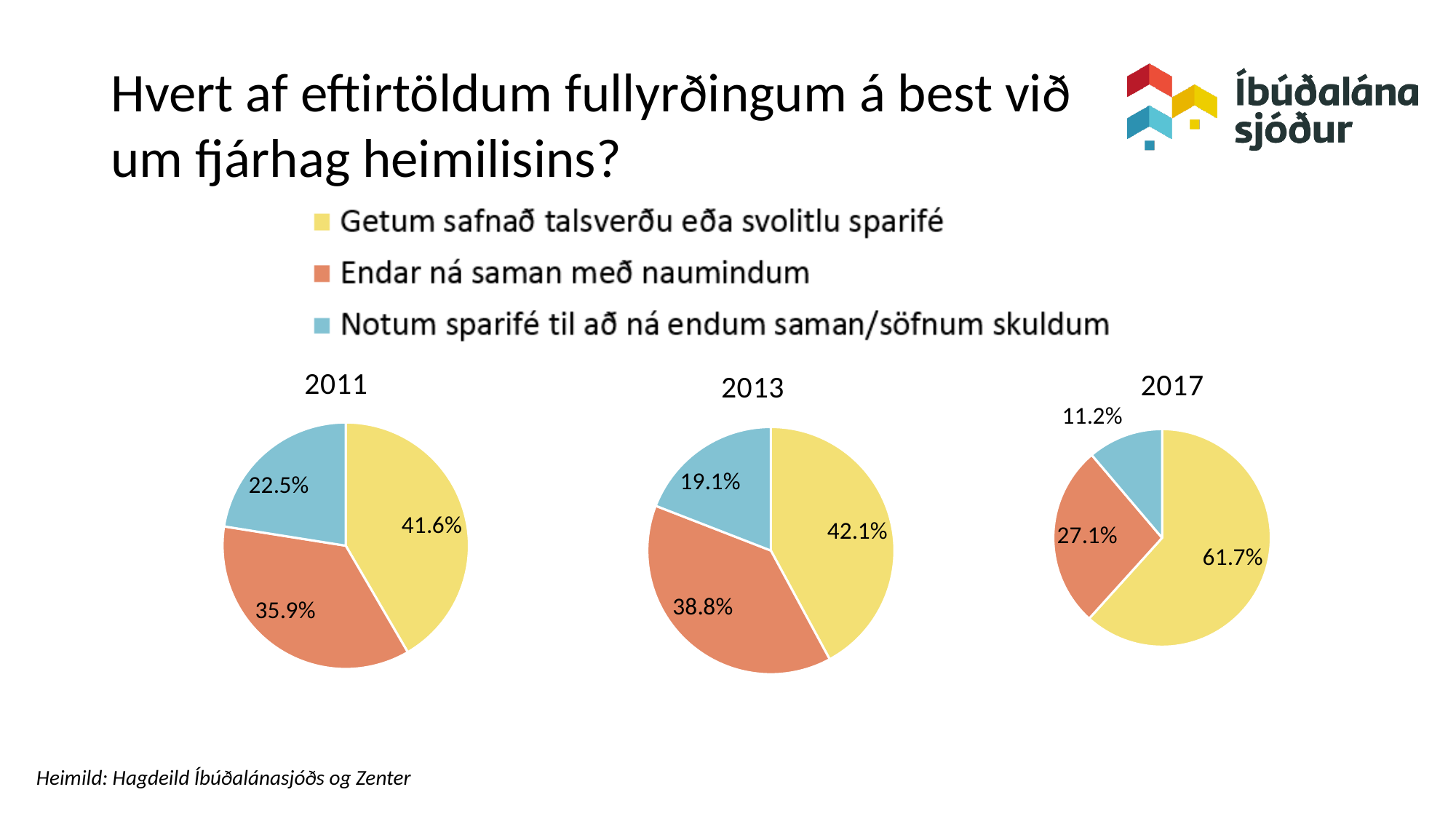
In the 2013 pie chart, what share is labelled for 'Endar ná saman með naumindum'? 38.8% In the 2011 pie chart, what share is labelled for 'Getum safnað talsverðu eða svolitlu sparifé'? 41.6% How many slices does the 2013 pie chart have? 3 How many entries does the legend list? 3 In the 2017 pie chart, which category has the largest slice? Getum safnað talsverðu eða svolitlu sparifé Across the 2011, 2013 and 2017 pie charts, does the share for 'Notum sparifé til að ná endum saman/söfnum skuldum' rise or fall over time? Fall In the 2017 pie chart, what share is labelled for 'Notum sparifé til að ná endum saman/söfnum skuldum'? 11.2% Comparing the 2011 and 2017 pie charts, which year has the larger share for 'Endar ná saman með naumindum'? 2011 In the 2017 pie chart, what is the difference between the 'Getum safnað talsverðu eða svolitlu sparifé' slice and the 'Endar ná saman með naumindum' slice? 34.6% What kind of chart is used for the 2011, 2013 and 2017 data? Pie chart In the 2011 pie chart, which category has the smallest slice? Notum sparifé til að ná endum saman/söfnum skuldum In the 2013 pie chart, what is the difference between the 'Getum safnað talsverðu eða svolitlu sparifé' slice and the 'Endar ná saman með naumindum' slice? 3.3%